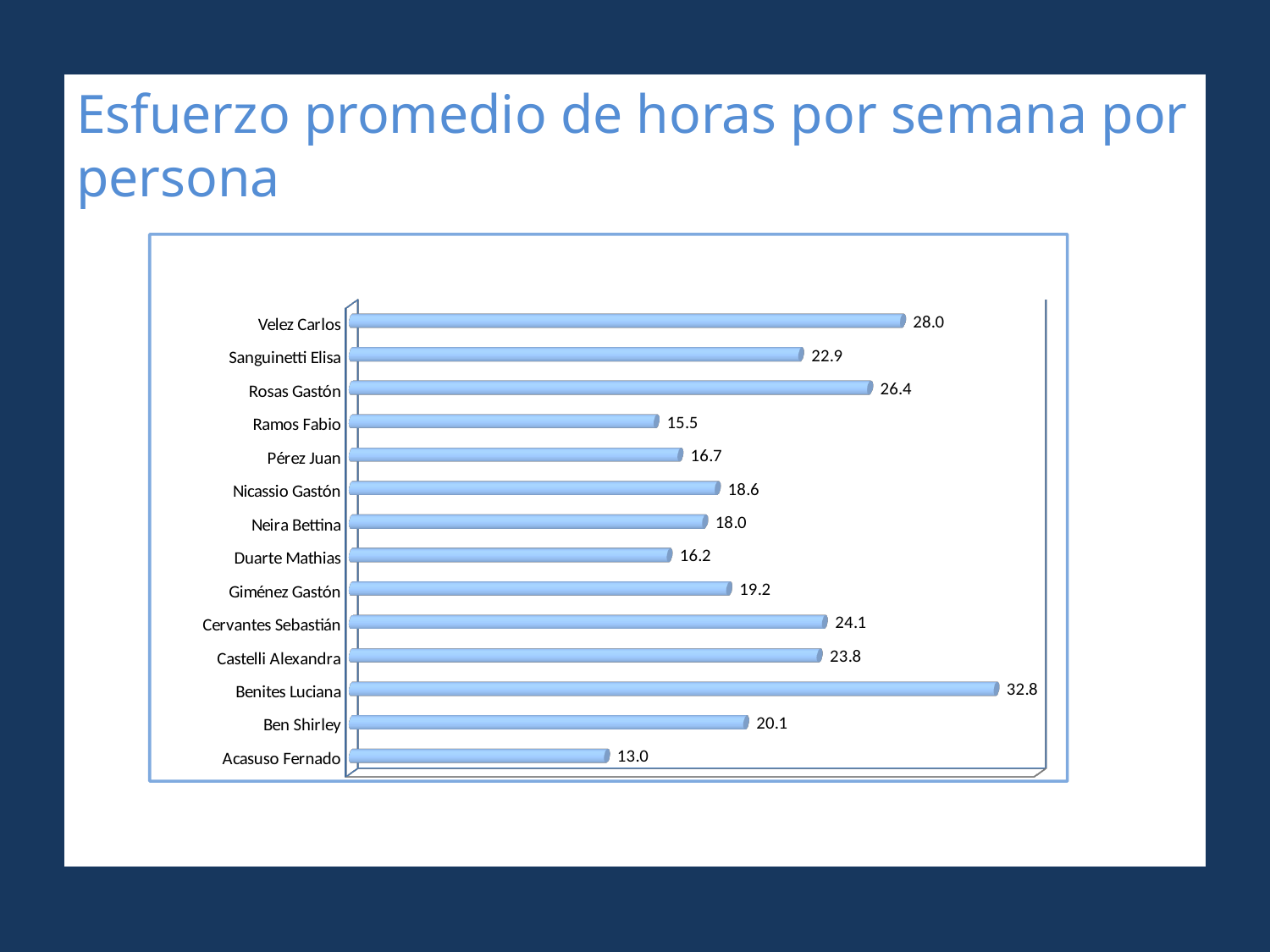
What kind of chart is shown on the slide? Bar chart What is the value for Velez Carlos? 28.0 Which person has the lowest value? Acasuso Fernado How many people are shown in the chart? 14 What is the value for Ramos Fabio? 15.5 What is the difference between the values for Velez Carlos and Sanguinetti Elisa? 5.1 What is the difference between the values for Benites Luciana and Acasuso Fernado? 19.8 Which is larger, the value for Rosas Gastón or the value for Cervantes Sebastián? Rosas Gastón What is the value for Ben Shirley? 20.1 Which person has the highest value? Benites Luciana What is the value for Castelli Alexandra? 23.8 What is the title of the slide? Esfuerzo promedio de horas por semana por persona